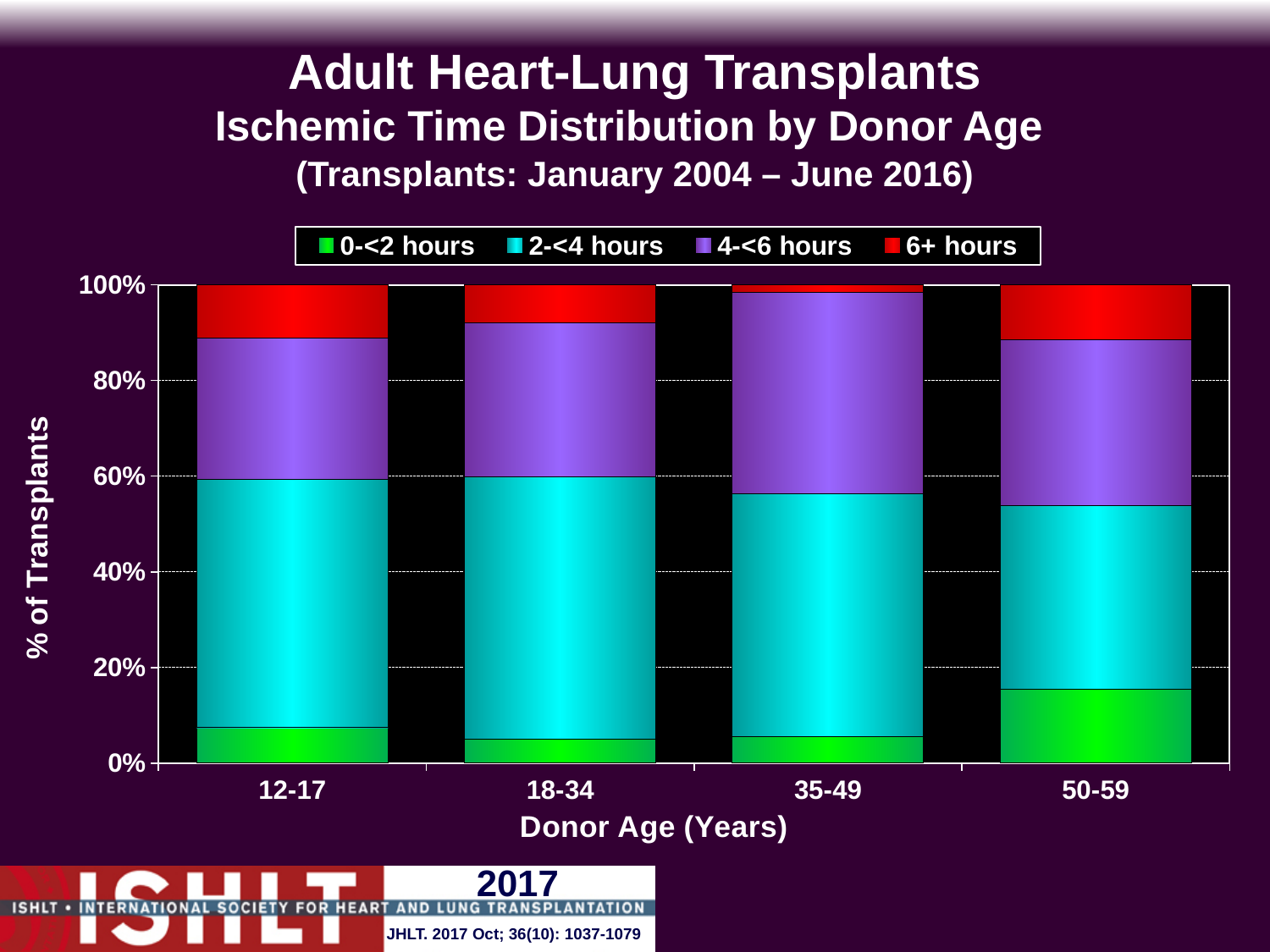
Is the 6+ hours share larger for the 50-59 group or the 35-49 group? 50-59 Is the 0-<2 hours share larger for the 50-59 group or the 12-17 group? 50-59 Is the 0-<2 hours share for the 50-59 group greater or less than 20%? less Is the 0-<2 hours share for the 18-34 group greater or less than 20%? less Which donor age group has the smallest 6+ hours share? 35-49 What does each stacked bar total? 100% How many donor age groups are shown on the x axis? 4 What is the title of the x axis? Donor Age (Years) Which donor age group has the largest 0-<2 hours share? 50-59 Which donor age group has the largest 4-<6 hours share? 35-49 What kind of chart is shown on the slide? Stacked bar chart How many series does the legend list? 4